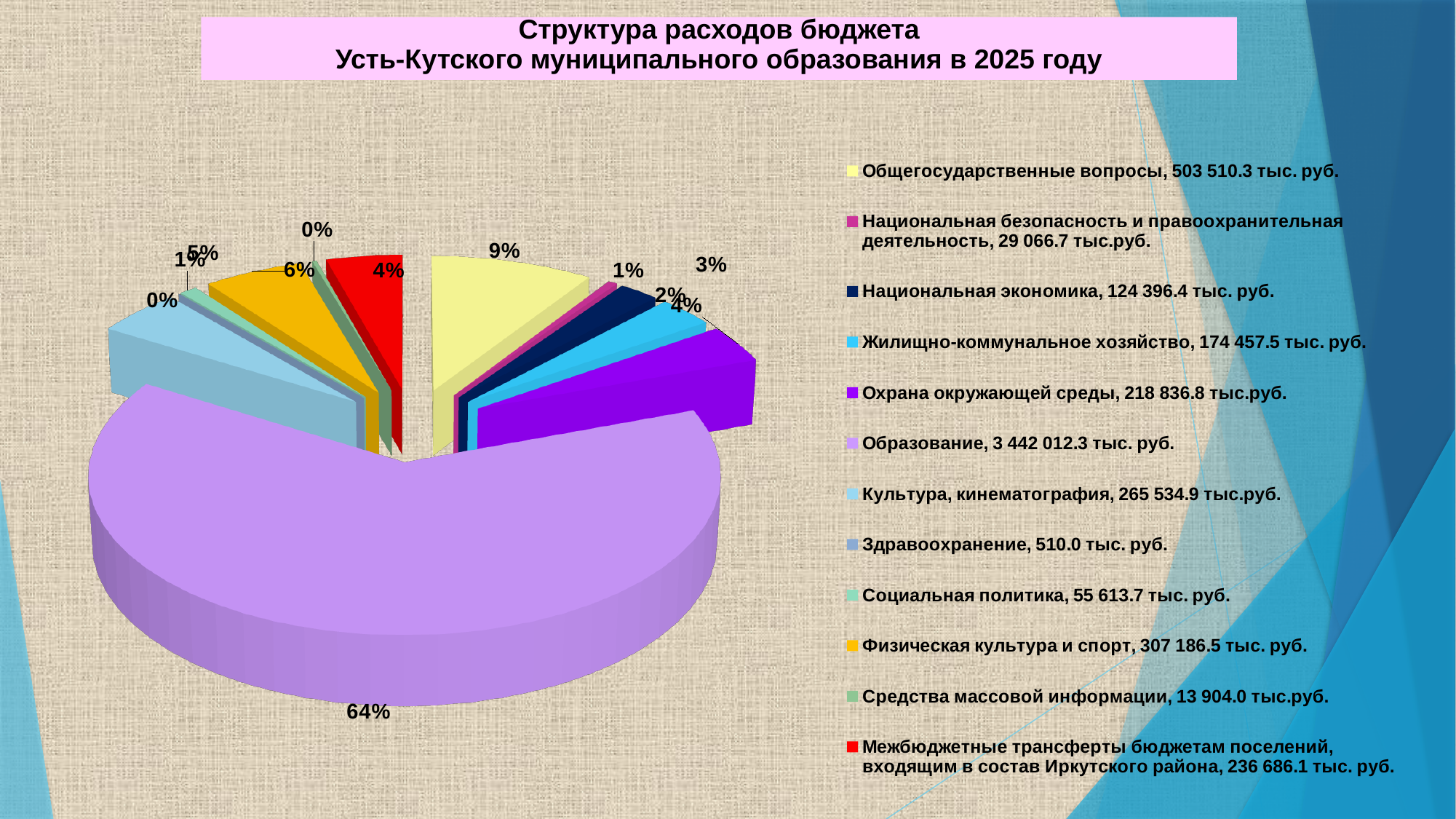
What share of the pie does Общегосударственные вопросы take? 9% Which category has the smallest value in the legend? Здравоохранение How many categories does the legend of the pie chart list? 12 Which category has the largest share of the pie? Образование What is the value for Жилищно-коммунальное хозяйство according to the legend? 174 457.5 тыс. руб. What is the title of the chart? Структура расходов бюджета Усть-Кутского муниципального образования в 2025 году What kind of chart is shown on the slide? pie chart What is the difference between the values for Физическая культура и спорт and Культура, кинематография? 41 651.6 тыс. руб. What is the value for Физическая культура и спорт according to the legend? 307 186.5 тыс. руб. Which is larger: Охрана окружающей среды or Национальная экономика? Охрана окружающей среды What is the value for Образование according to the legend? 3 442 012.3 тыс. руб. What share of the pie does Образование take? 64%